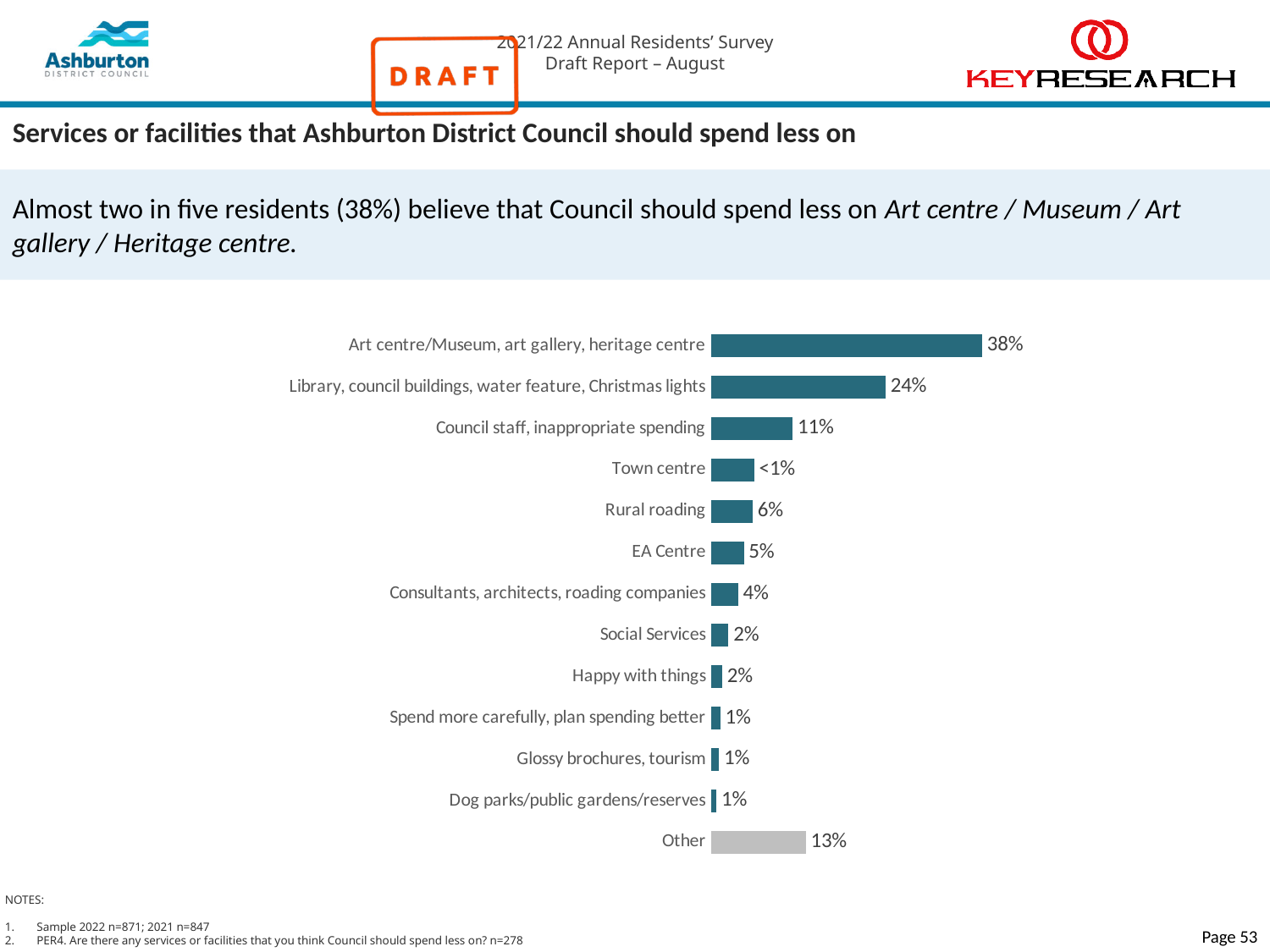
Which has a higher value, EA Centre or Consultants, architects, roading companies? EA Centre Which has a higher value, Rural roading or Social Services? Rural roading What percentage is shown for Rural roading? 6% Which category has the highest percentage in the chart? Art centre/Museum, art gallery, heritage centre How many categories are shown in the chart? 13 What is the value shown for Library, council buildings, water feature, Christmas lights? 24% What is the difference in percentage points between Art centre/Museum, art gallery, heritage centre and Library, council buildings, water feature, Christmas lights? 14 What type of chart is shown on the slide? Bar chart What is the difference in percentage points between Other and Council staff, inappropriate spending? 2 What value is shown for the Other category? 13% What percentage is shown for Council staff, inappropriate spending? 11% What percentage of residents said Council should spend less on Art centre/Museum, art gallery, heritage centre? 38%